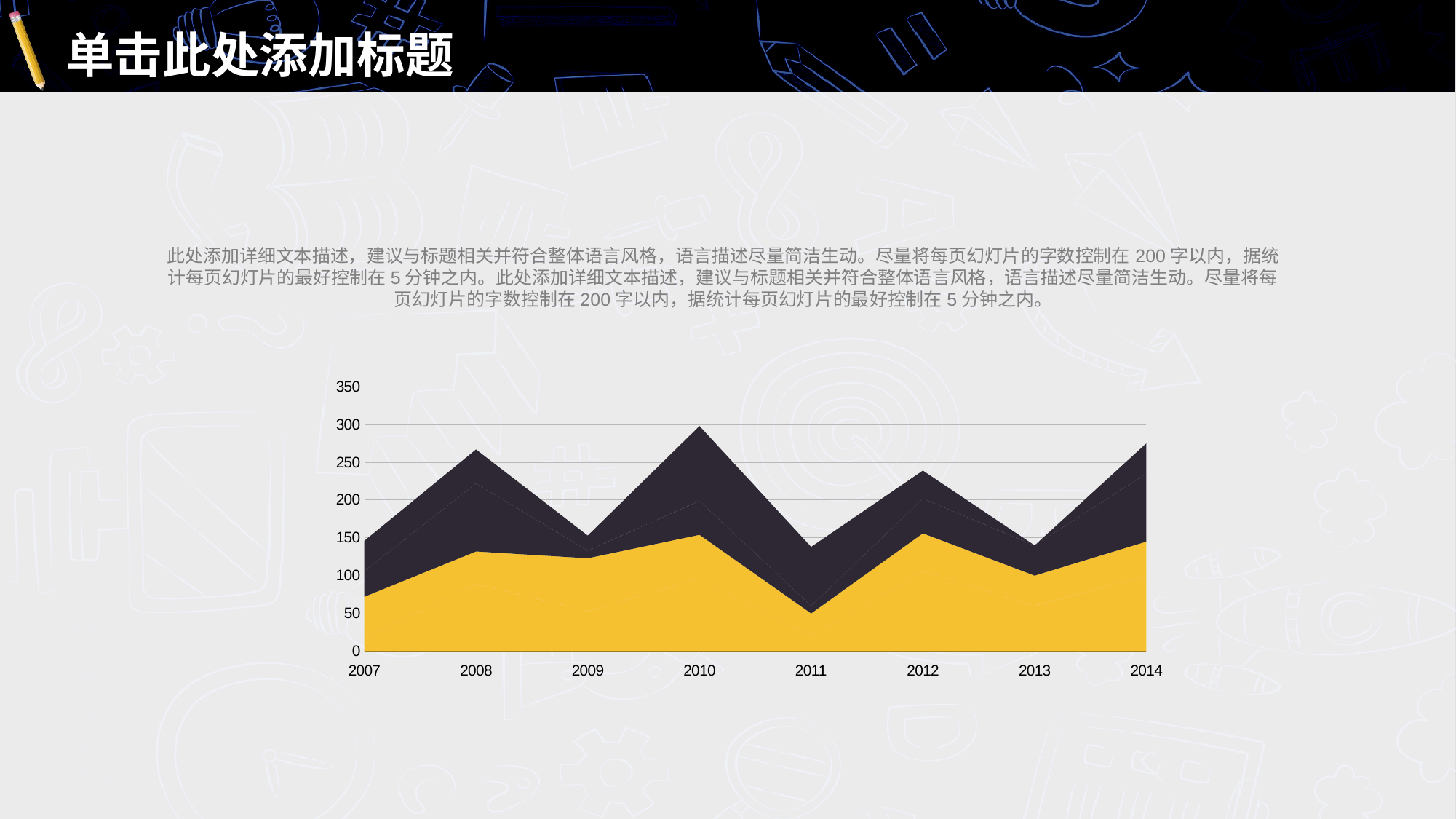
Does the top of the stacked area rise or fall from 2013 to 2014? rise What kind of chart is shown on the slide? area chart Is the top of the stacked area for 2010 greater or less than 250? greater Is the value of the yellow series for 2008 greater or less than 100? greater In which year is the yellow (bottom) series at its lowest? 2011 What is the highest value shown on the y axis of the chart? 350 How many years are shown on the x axis of the chart? 8 Is the value of the yellow series for 2011 greater or less than 100? less Which year has a higher top of the stacked area: 2008 or 2009? 2008 Which year has the highest top of the stacked area? 2010 Which is larger for the yellow series: the value for 2010 or the value for 2011? 2010